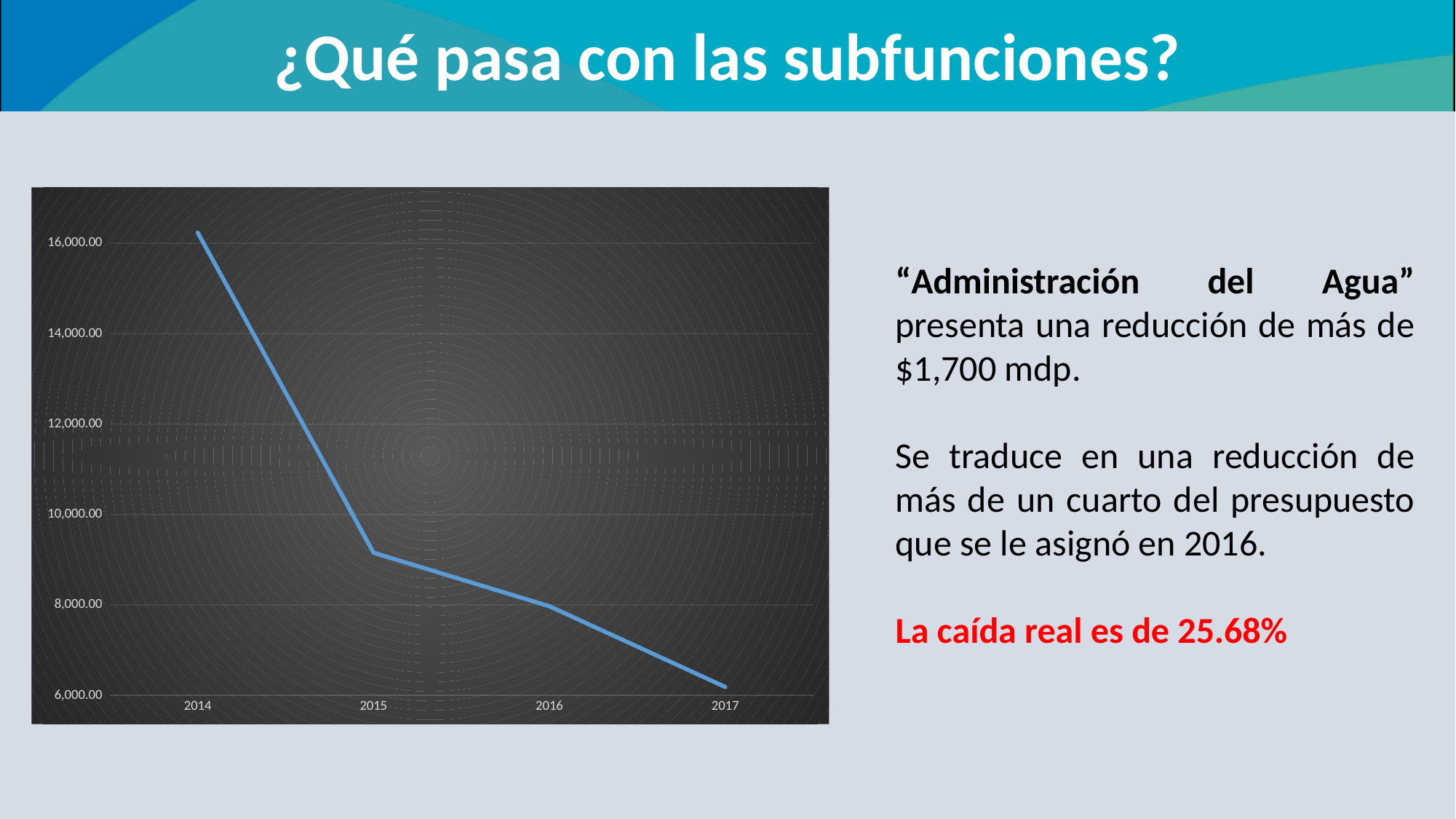
Is the value for 2016 greater or less than 10,000.00? less Which is larger, the value for 2014 or the value for 2017? 2014 Is the value for 2017 greater or less than 8,000.00? less What kind of chart is shown on the slide? line chart What colour is the line plotted in the chart? blue Which year has the lowest value in the chart? 2017 Which year has the highest value in the chart? 2014 Do the values rise or fall from 2014 to 2017? fall How many years are plotted along the x axis of the chart? 4 Is the value for 2014 greater or less than 14,000.00? greater Which is larger, the value for 2015 or the value for 2016? 2015